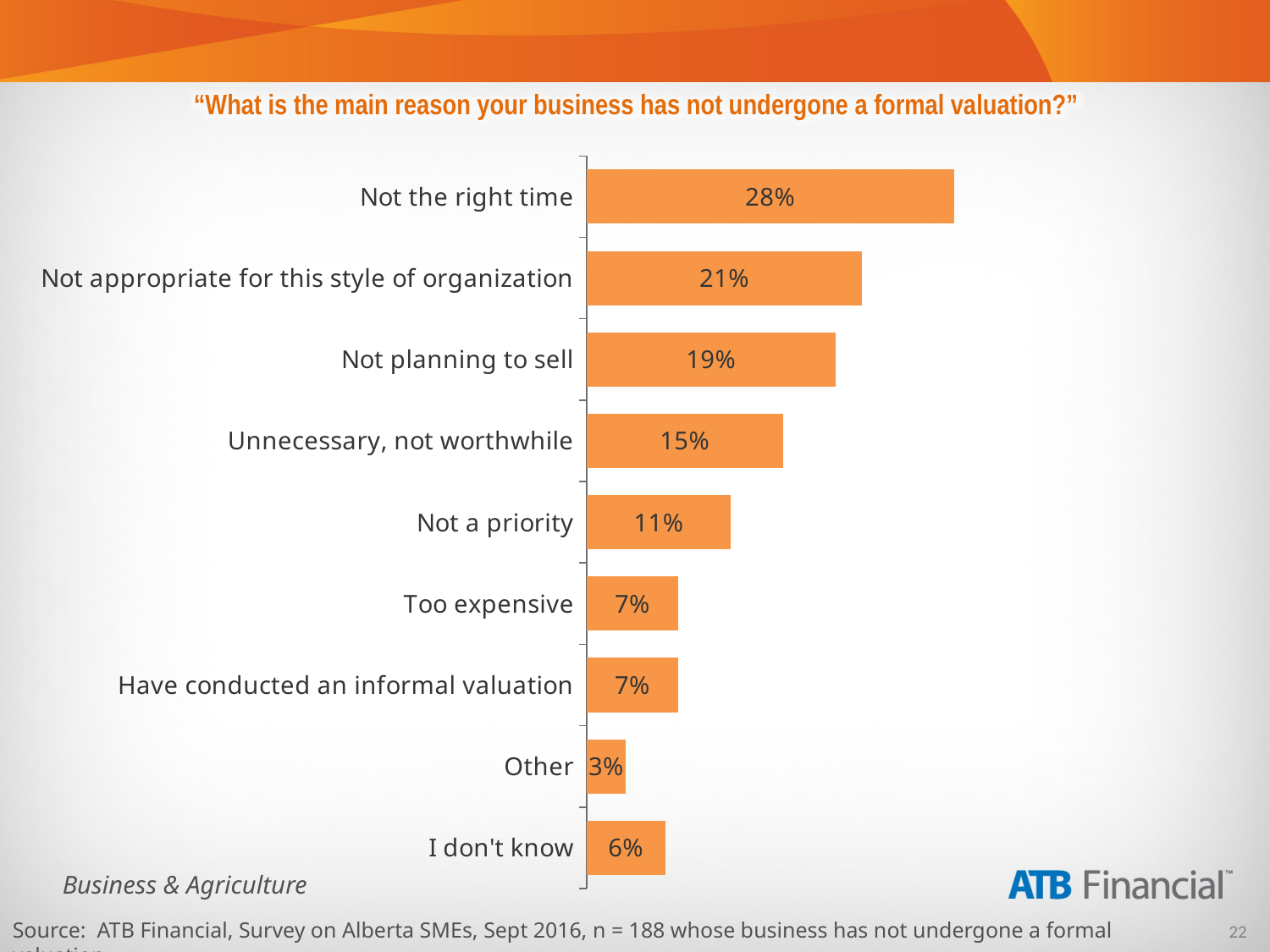
What percentage chose "Unnecessary, not worthwhile"? 15% What is the difference between "Not the right time" and "Not appropriate for this style of organization"? 7% What is the value for "Not planning to sell"? 19% What percentage of respondents said "Not the right time"? 28% How many categories are shown in the chart? 9 What is the value for "I don't know"? 6% What is the difference between "Not a priority" and "Too expensive"? 4% What question is the chart titled with? "What is the main reason your business has not undergone a formal valuation?" Which is larger, "Not planning to sell" or "Unnecessary, not worthwhile"? Not planning to sell Which reason has the highest percentage? Not the right time Which category has the lowest percentage? Other What kind of chart is shown on the slide? Bar chart